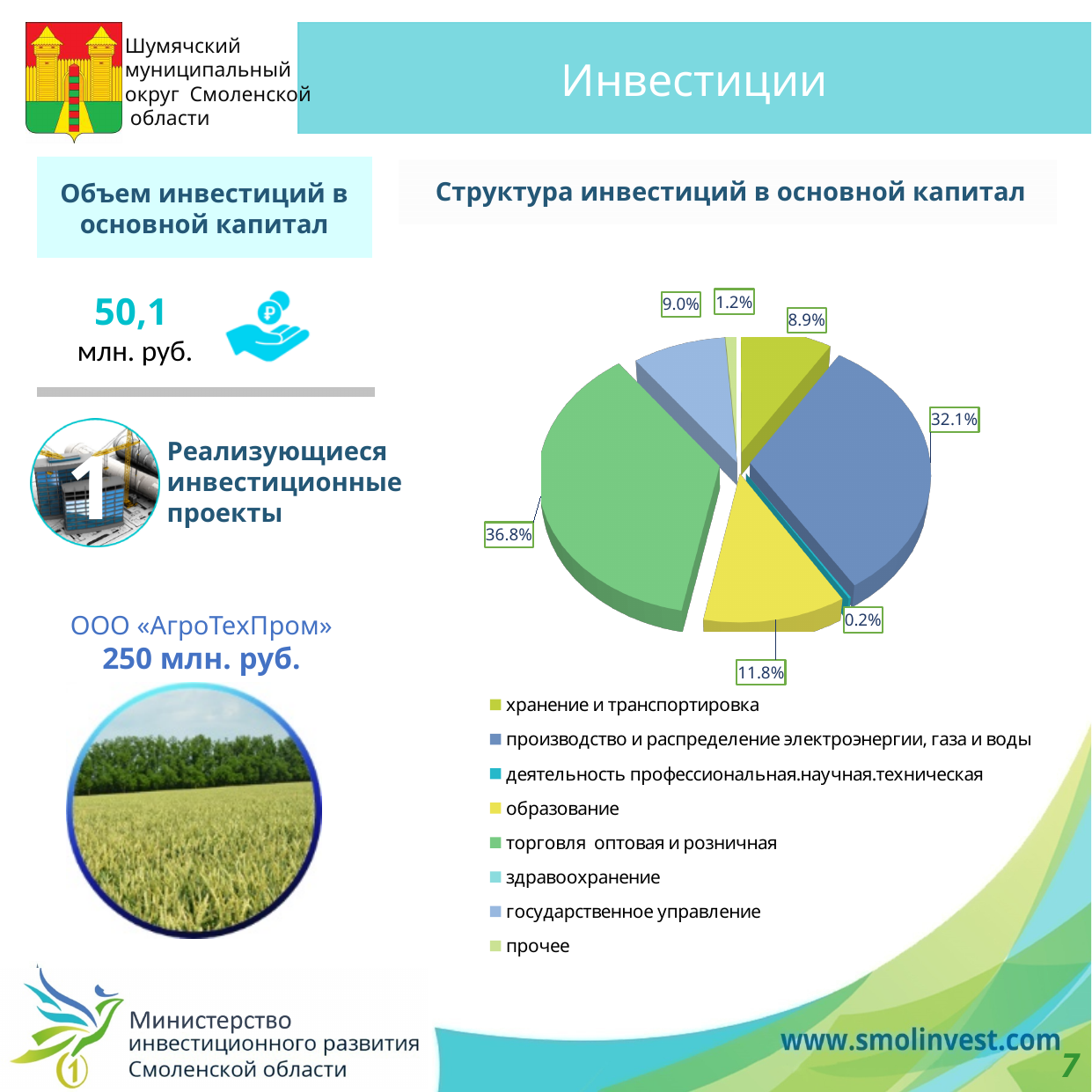
In the pie chart "Структура инвестиций в основной капитал", what share does "прочее" have? 1.2% How many entries does the legend of the pie chart "Структура инвестиций в основной капитал" list? 8 In the pie chart "Структура инвестиций в основной капитал", which category has the largest share? торговля оптовая и розничная In the pie chart "Структура инвестиций в основной капитал", what share does "деятельность профессиональная.научная.техническая" have? 0.2% In the pie chart "Структура инвестиций в основной капитал", what share does "торговля оптовая и розничная" have? 36.8% In the pie chart "Структура инвестиций в основной капитал", what share does "хранение и транспортировка" have? 8.9% In the pie chart "Структура инвестиций в основной капитал", what share does "государственное управление" have? 9.0% In the pie chart "Структура инвестиций в основной капитал", which is larger: "образование" or "государственное управление"? образование In the pie chart "Структура инвестиций в основной капитал", what share does "образование" have? 11.8% In the pie chart "Структура инвестиций в основной капитал", what is the difference between the shares of "торговля оптовая и розничная" and "производство и распределение электроэнергии, газа и воды"? 4.7% What type of chart is shown under the title "Структура инвестиций в основной капитал"? pie chart In the pie chart "Структура инвестиций в основной капитал", what share does "производство и распределение электроэнергии, газа и воды" have? 32.1%